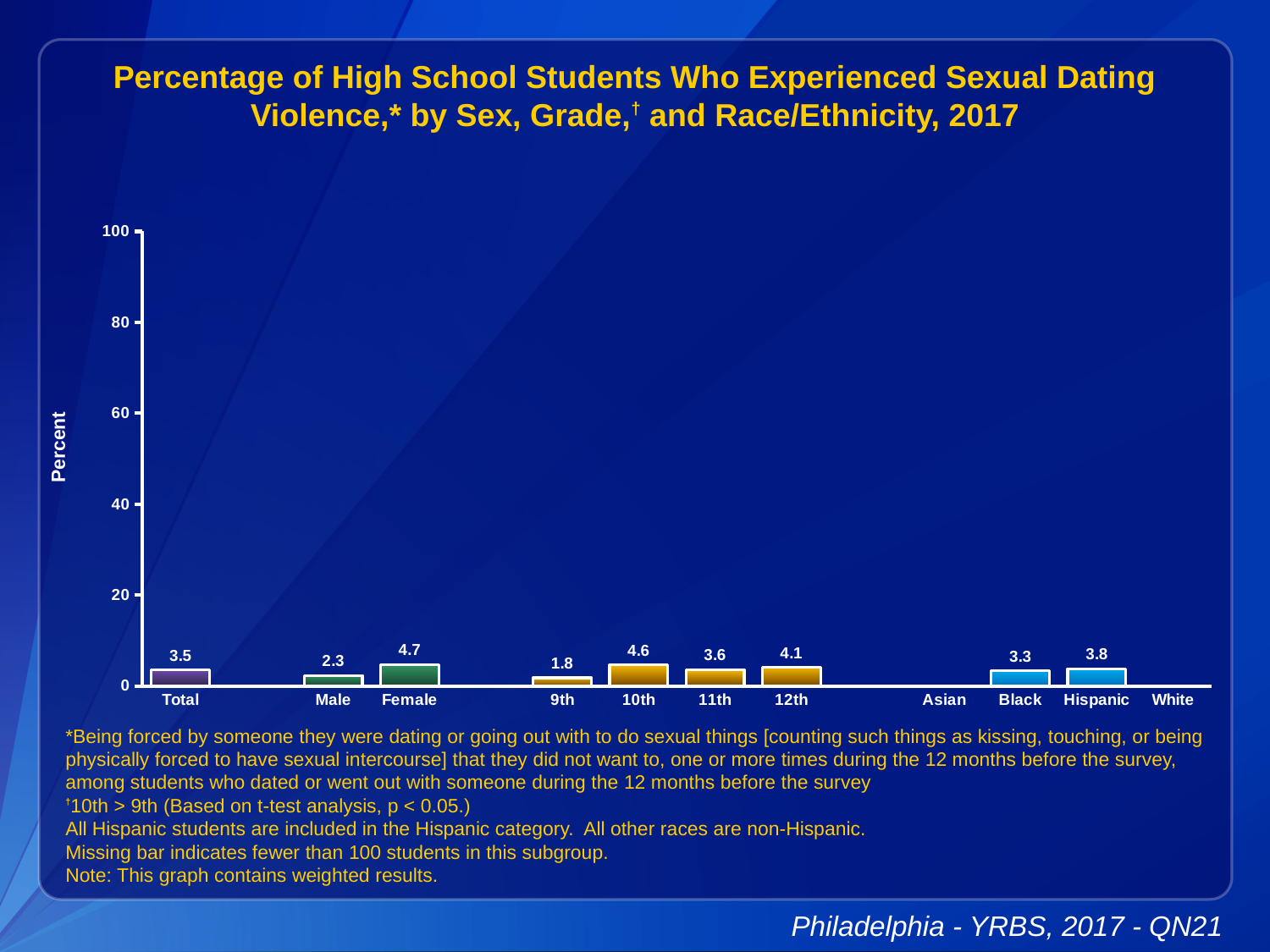
What kind of chart is this? bar chart Which category has the lowest value among the bars shown? 9th Which is larger, the value for 10th grade or 11th grade? 10th Which category has the highest value? Female What is the difference between the Female and Male values? 2.4 What is the value for Female? 4.7 What is the value for 9th grade? 1.8 What is the value for Hispanic? 3.8 How many categories have a bar plotted? 9 What is the label of the y axis? Percent Is the value for 12th grade greater or less than 20? less What is the value for Total? 3.5